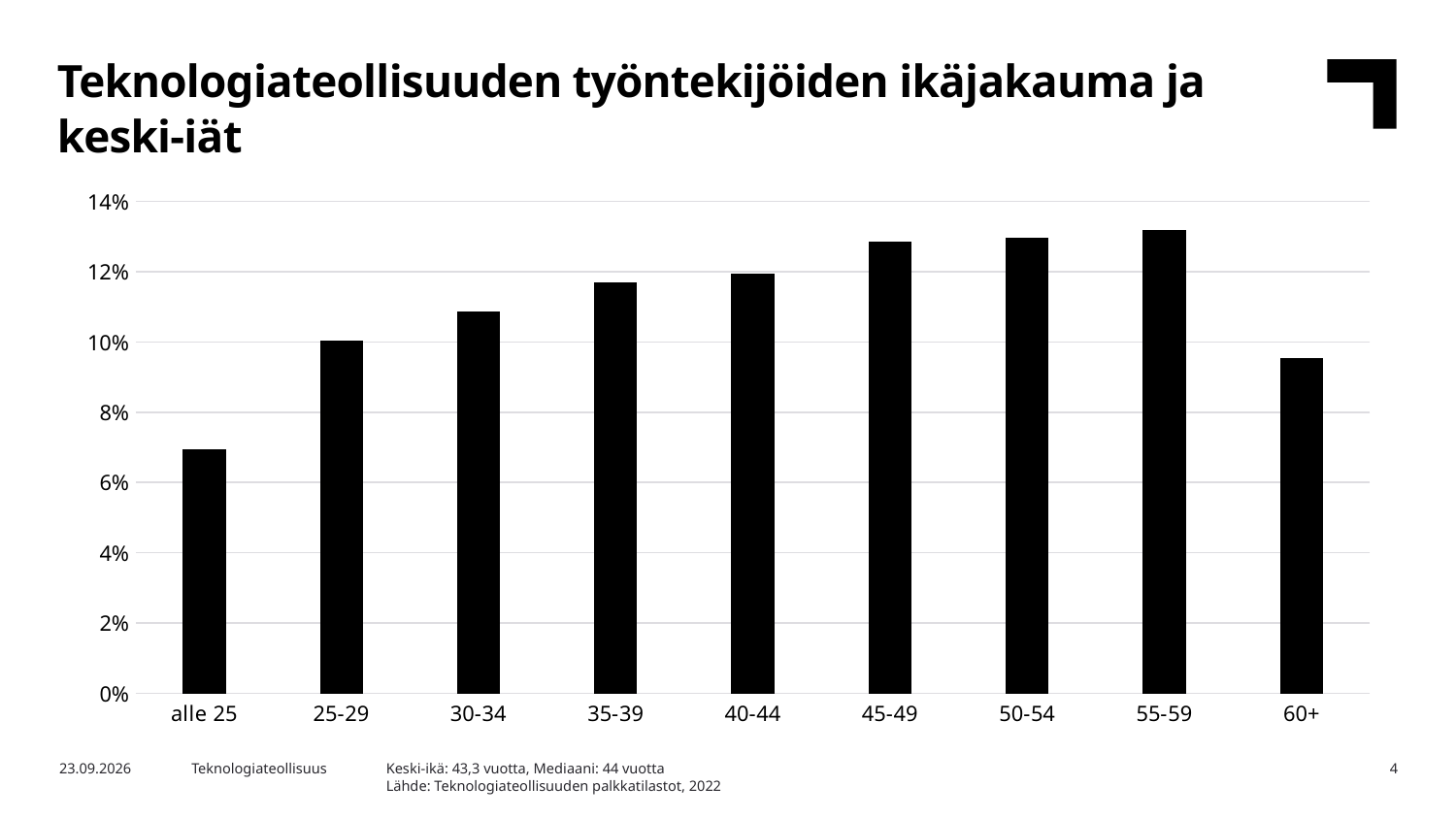
Is the value for 60+ greater or less than 10%? less Which is larger, the value for 30-34 or the value for 35-39? 35-39 How do the values change from alle 25 to 55-59 along the x axis? They rise Is the value for alle 25 greater or less than 8%? less What is the title of the chart on the slide? Teknologiateollisuuden työntekijöiden ikäjakauma ja keski-iät Which is larger, the value for 60+ or the value for alle 25? 60+ Which age group has the lowest share of employees? alle 25 Is the value for 45-49 greater or less than 12%? greater Which age group has the highest share of employees? 55-59 What kind of chart is shown on the slide? Bar chart How many age groups are shown on the x axis? 9